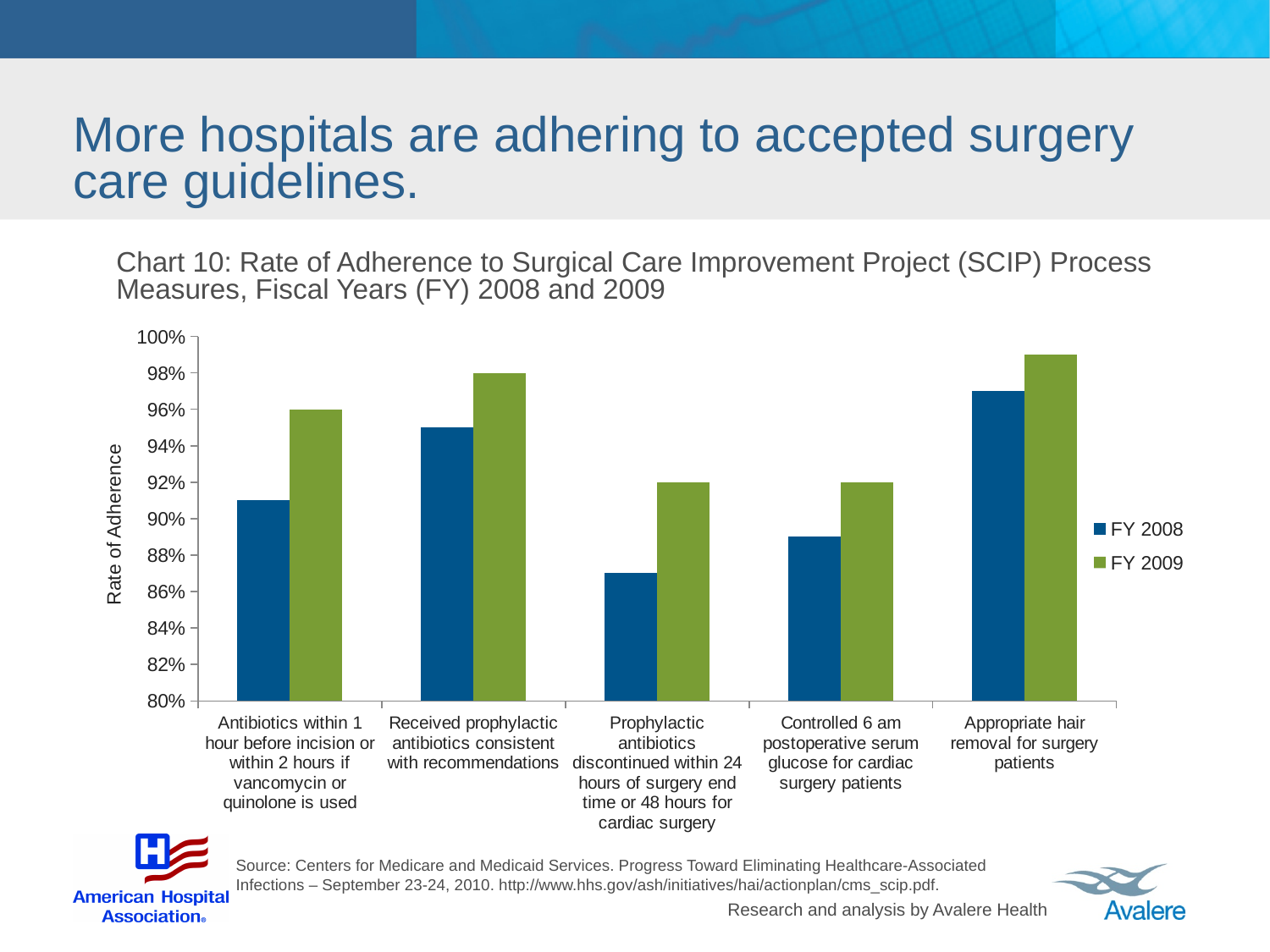
Which process measure has the highest FY 2009 rate of adherence? Appropriate hair removal for surgery patients Is the FY 2008 value for 'Controlled 6 am postoperative serum glucose for cardiac surgery patients' greater or less than 90%? less What is the FY 2009 rate of adherence for 'Antibiotics within 1 hour before incision or within 2 hours if vancomycin or quinolone is used'? 96% How many series does the legend list? 2 What is the FY 2009 rate of adherence for 'Prophylactic antibiotics discontinued within 24 hours of surgery end time or 48 hours for cardiac surgery'? 92% How many process measures (categories) are shown on the x axis? 5 Is the FY 2008 value for 'Appropriate hair removal for surgery patients' greater or less than 96%? greater Which process measure has the lowest FY 2008 rate of adherence? Prophylactic antibiotics discontinued within 24 hours of surgery end time or 48 hours for cardiac surgery For 'Received prophylactic antibiotics consistent with recommendations', which is larger, the FY 2008 or the FY 2009 value? FY 2009 What label is shown on the vertical axis of the chart? Rate of Adherence What type of chart is shown on the slide? bar chart What is the FY 2009 rate of adherence for 'Received prophylactic antibiotics consistent with recommendations'? 98%